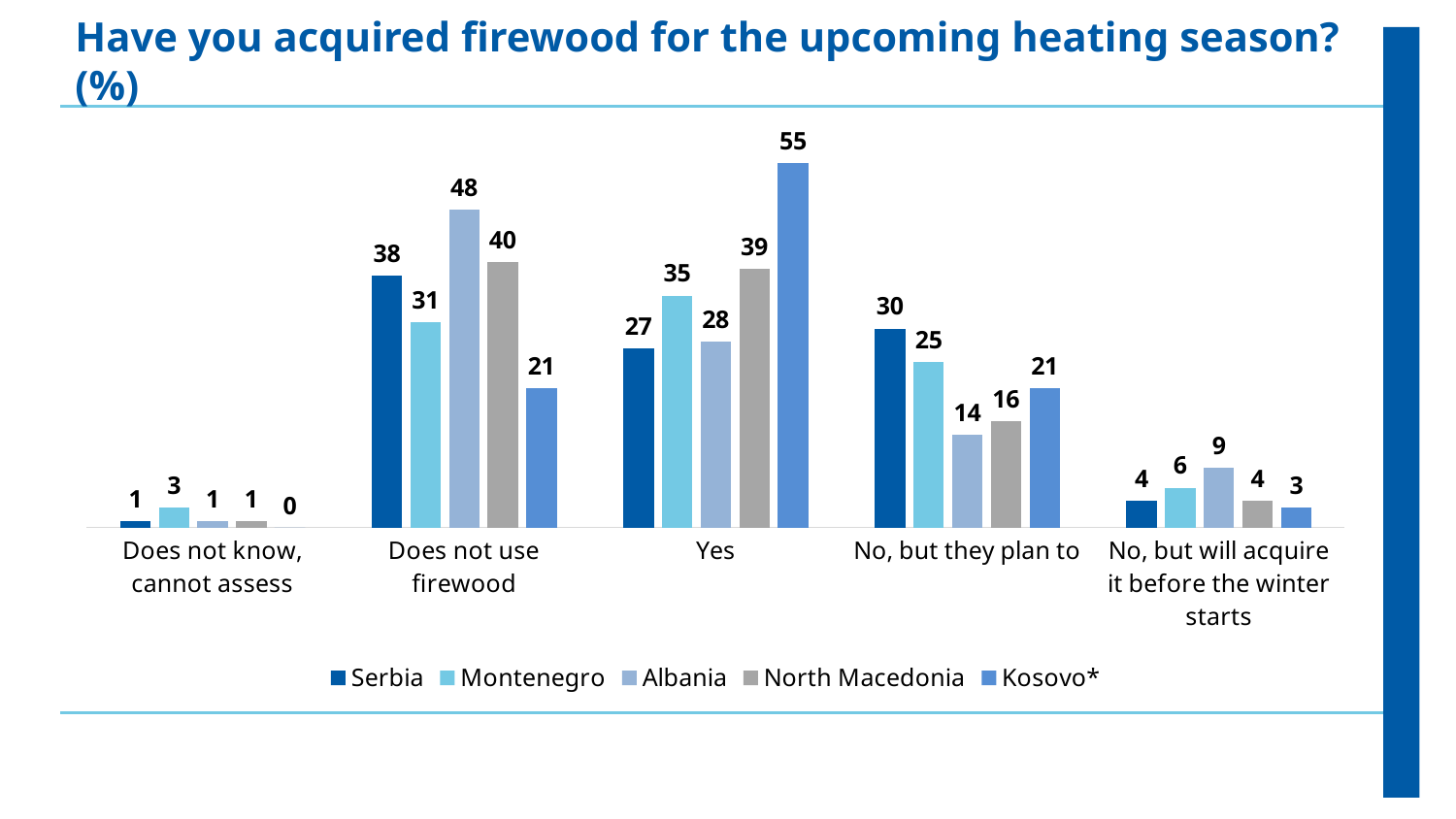
How many series does the legend list? 5 What is the value for North Macedonia in the "No, but will acquire it before the winter starts" category? 4 What is the value for Albania in the "Does not use firewood" category? 48 What is the value for Serbia in the "No, but they plan to" category? 30 How many response categories are shown on the x axis? 5 What is the value for Kosovo* in the "Yes" category? 55 Which country has the highest value in the "Yes" category? Kosovo* Which is larger in the "No, but they plan to" category: Montenegro or Albania? Montenegro Which country has the lowest value in the "Does not use firewood" category? Kosovo* Which series is shown in the darkest blue colour in the legend? Serbia What is the difference between Kosovo* and Serbia in the "Yes" category? 28 What kind of chart is shown on the slide? Bar chart